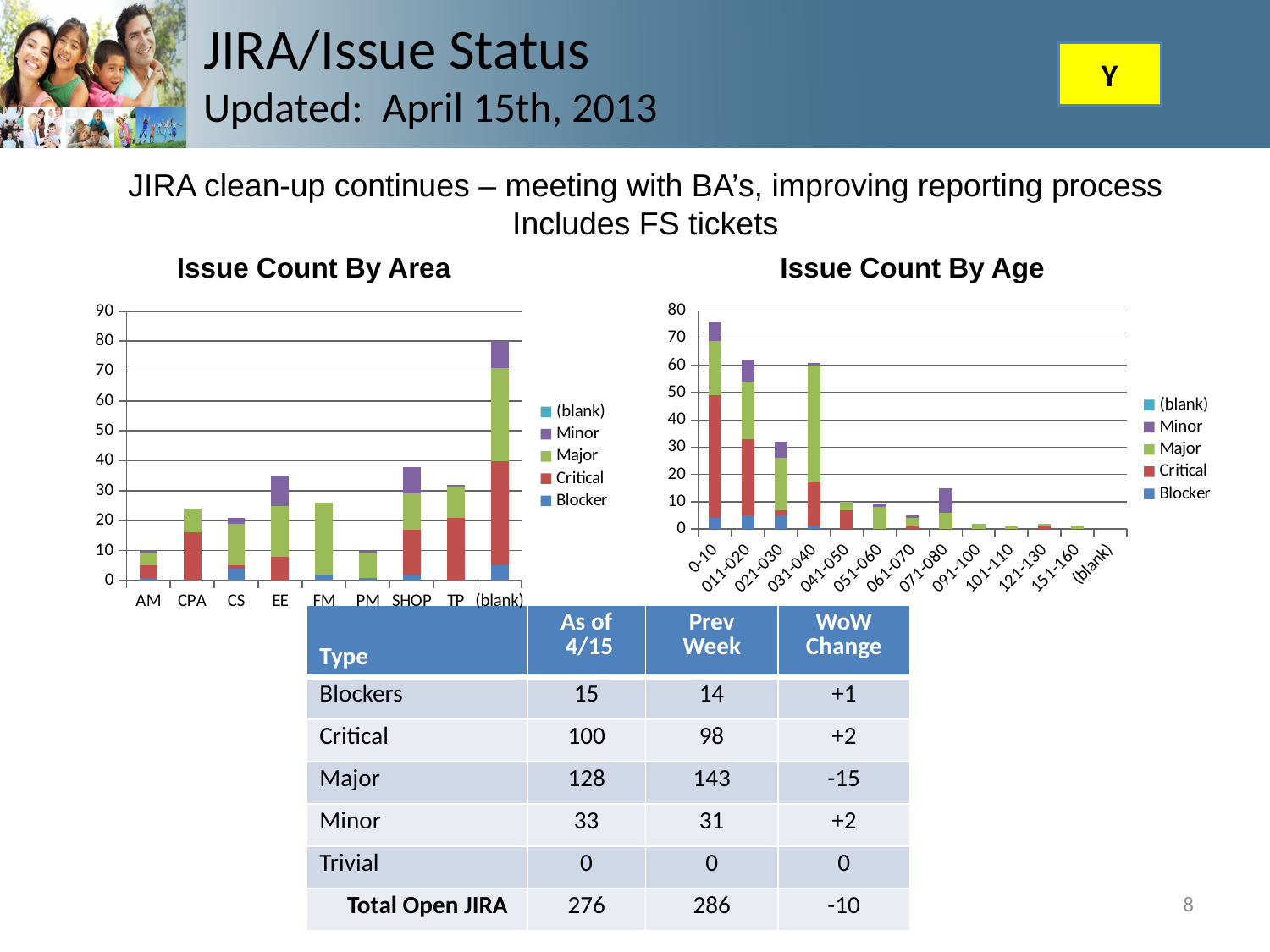
How many categories are shown on the x axis of the "Issue Count By Area" chart? 9 In the "Issue Count By Age" chart, which has the taller stacked bar, 0-10 or 011-020? 0-10 In the "Issue Count By Area" chart, which category has the tallest stacked bar? (blank) How many series does the legend of the "Issue Count By Age" chart list? 5 In the "Issue Count By Area" chart, is the total for CPA greater or less than 30? less How many categories are shown on the x axis of the "Issue Count By Age" chart? 13 In the "Issue Count By Age" chart, which age bucket has the tallest stacked bar? 0-10 In the "Issue Count By Age" chart, is the total for 031-040 greater or less than 50? greater In the "Issue Count By Area" chart, which has the taller stacked bar, SHOP or TP? SHOP In the "Issue Count By Age" chart, is the total for 0-10 greater or less than 70? greater What kind of chart is the "Issue Count By Area" chart? stacked bar chart